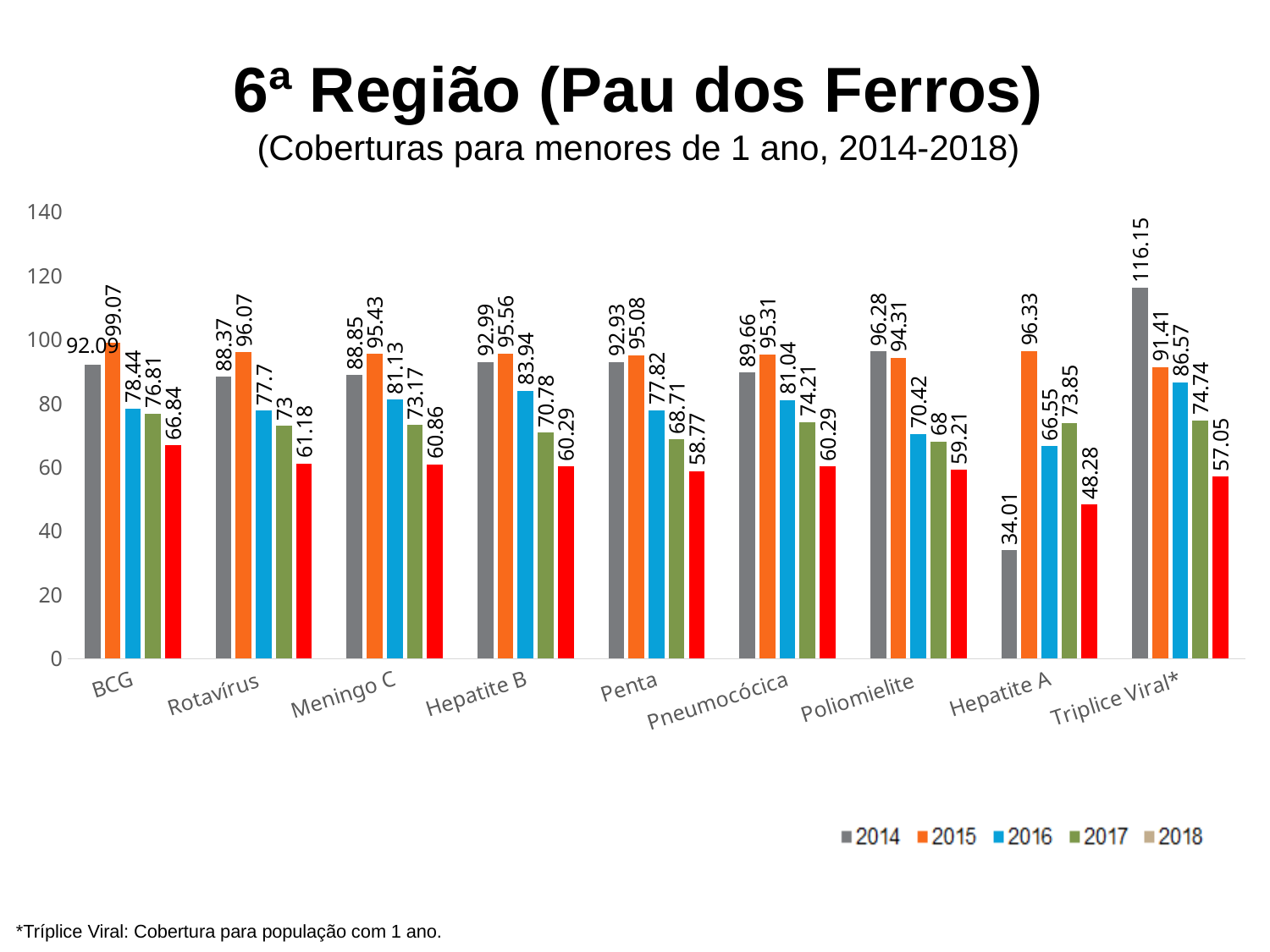
Which is larger for Poliomielite, the 2014 value or the 2015 value? 2014 What is the 2014 value for Hepatite A? 34.01 How many vaccine categories are shown on the x axis? 9 Which category has the lowest 2018 value? Hepatite A How many series does the legend list? 5 What kind of chart is shown on the slide? bar chart For Penta, do the values rise or fall from 2015 to 2018? fall What is the 2015 value for BCG? 99.07 Is the 2014 value for Triplice Viral* greater or less than 100? greater Which category has the highest 2014 value? Triplice Viral* What is the difference between the 2015 and 2014 values for Hepatite A? 62.32 What is the 2017 value for Rotavírus? 73